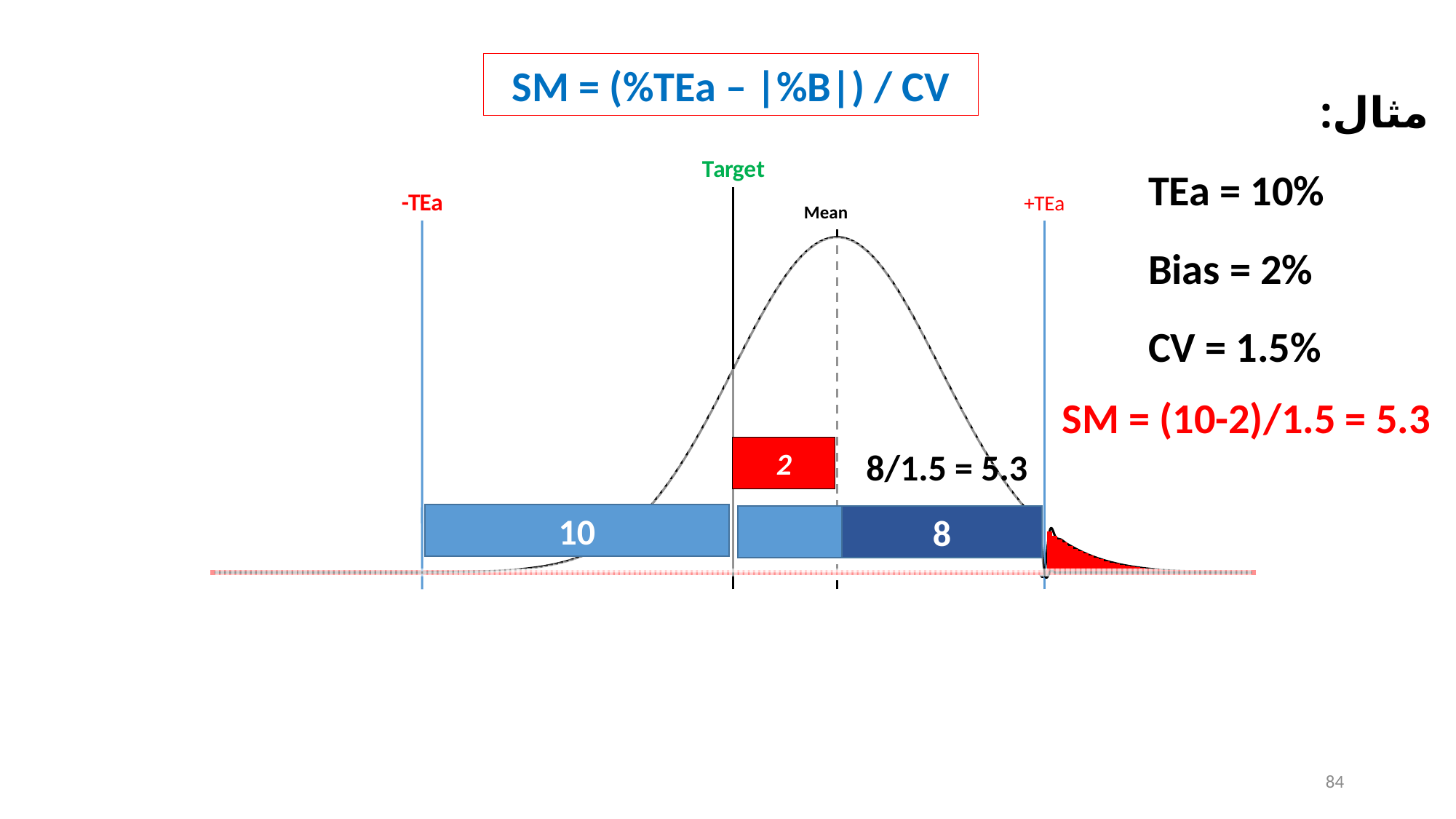
What result is printed next to the dark blue bar for 8 divided by 1.5? 5.3 How many numeric values are printed inside the bars and boxes of the diagram? 3 What is the difference between the value in the left blue bar (10) and the value in the red box (2)? 8 What value is printed in the red box above the bars? 2 Which is larger, the value in the left blue bar or the value in the dark blue bar? the left blue bar (10) What is the label above the dashed vertical line at the peak of the curve? Mean What value is printed in the light blue bar on the left, between -TEa and Target? 10 What is the label on the green vertical line in the diagram? Target Which labeled box has the smallest value? 2 What value is printed in the dark blue bar on the right, ending at +TEa? 8 Which labeled bar has the largest value? 10